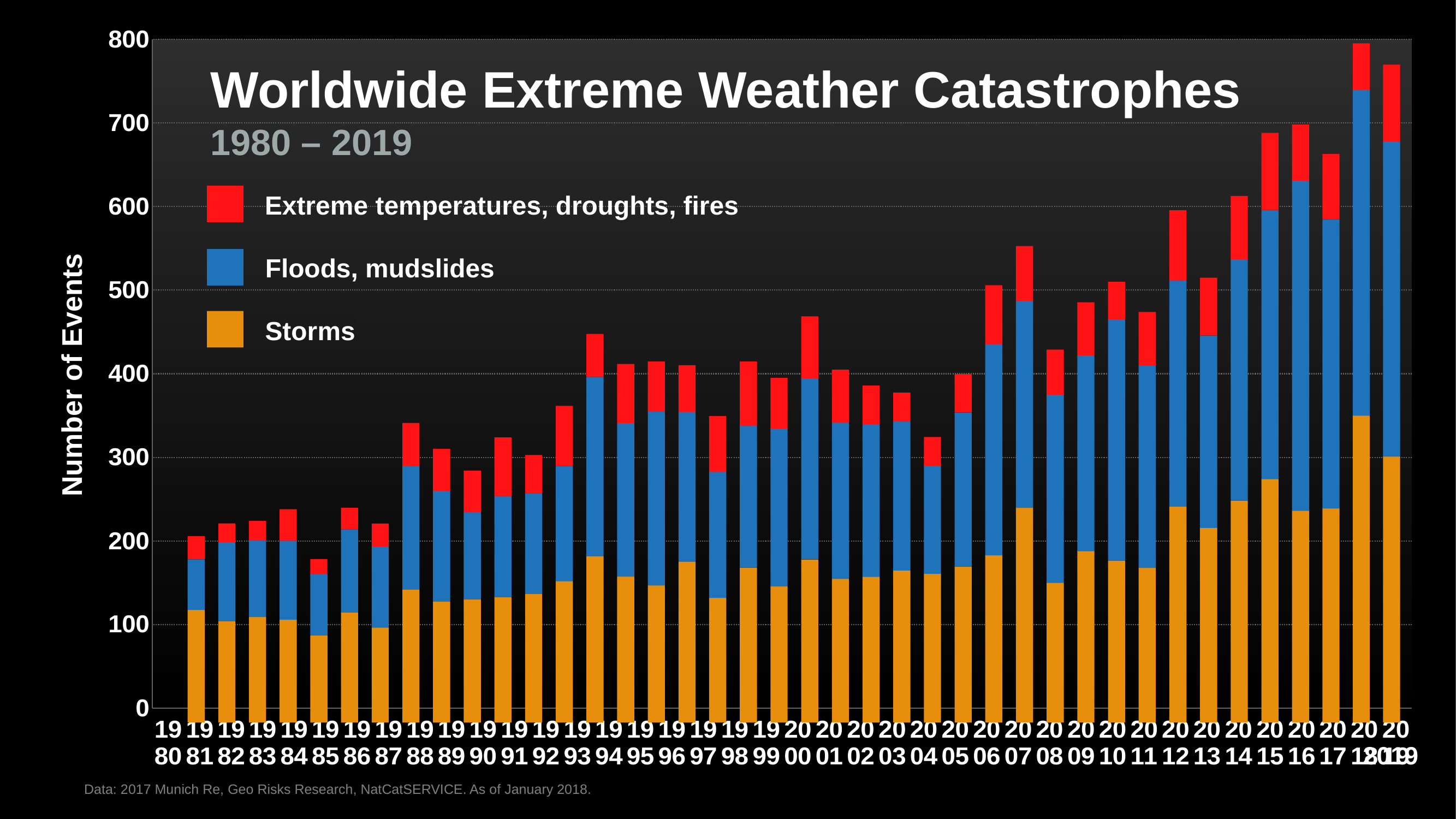
What kind of chart is shown on the slide? Stacked bar chart Which year has the lowest total number of events? 1985 Which year has a higher total number of events, 2012 or 2011? 2012 Is the total number of events in 2018 greater or less than 700? greater Which colour represents the Floods, mudslides series? Blue Is the total number of events in 1985 greater or less than 200? less How many years (bars) are plotted in the chart? 40 Overall, do the total number of events rise or fall from 1980 to 2019? Rise Which year has the highest total number of events? 2018 How many series does the legend list? 3 Is the number of Storms events in 2018 greater or less than 300? greater What is the title of the chart? Worldwide Extreme Weather Catastrophes